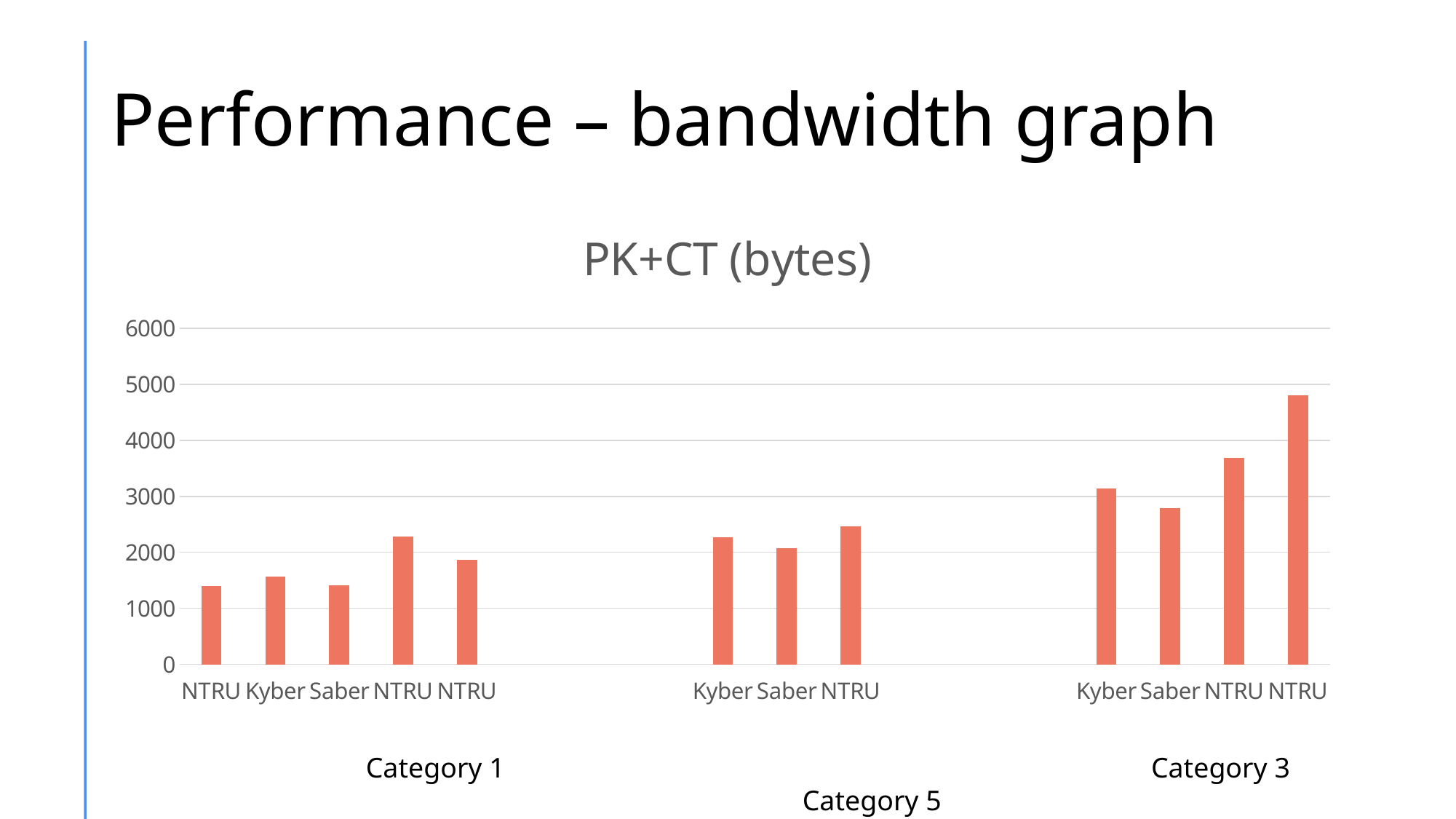
How many category groups (Category 1, Category 5, Category 3) are shown along the x axis? 3 Is the value for Kyber in Category 3 greater or less than 3000? greater Is the value for Saber in Category 3 greater or less than 3000? less Which bar is the highest in the chart? the last NTRU bar in Category 3 What kind of chart is shown on the slide? bar chart How many bars are in the Category 3 group? 4 In Category 3, which is larger, Kyber or Saber? Kyber In Category 1, which is larger, Kyber or Saber? Kyber What is the title of the chart? PK+CT (bytes) How many bars are plotted in the chart in total? 12 Is the value for Kyber in Category 5 greater or less than 2000? greater